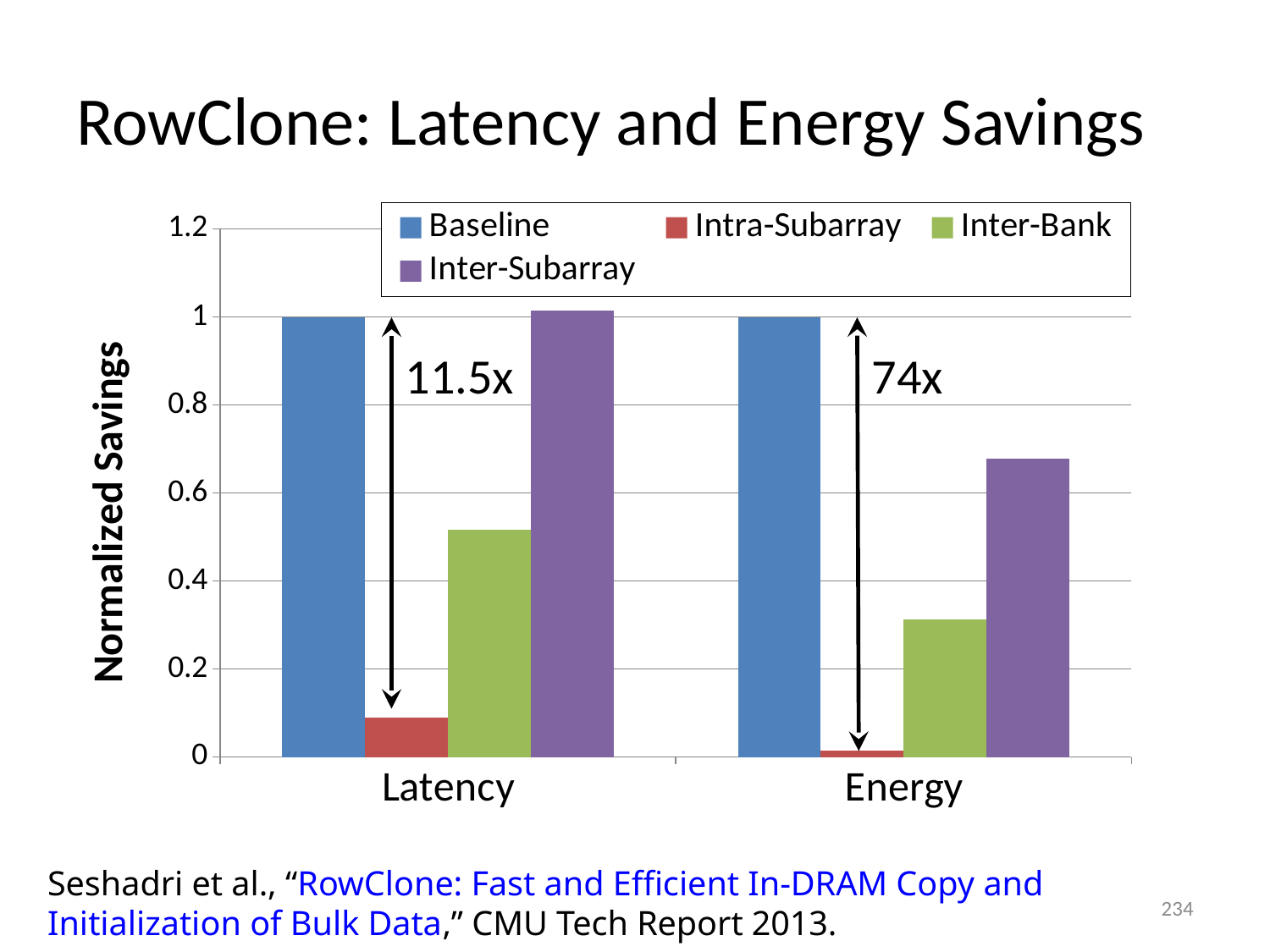
How many series does the legend list? 4 Is the Inter-Subarray value for Energy greater or less than 0.6? greater Is the Inter-Bank value larger for Latency or for Energy? Latency How many categories are shown on the x axis? 2 Is the Inter-Bank value for Energy greater or less than 0.4? less What improvement factor is annotated above the Latency group? 11.5x What is the Baseline value for Energy? 1 What kind of chart is shown on the slide? bar chart Is the Inter-Bank value for Latency greater or less than 0.4? greater What is the title of the y axis? Normalized Savings Which series has the lowest value for Energy? Intra-Subarray What is the Baseline value for Latency? 1